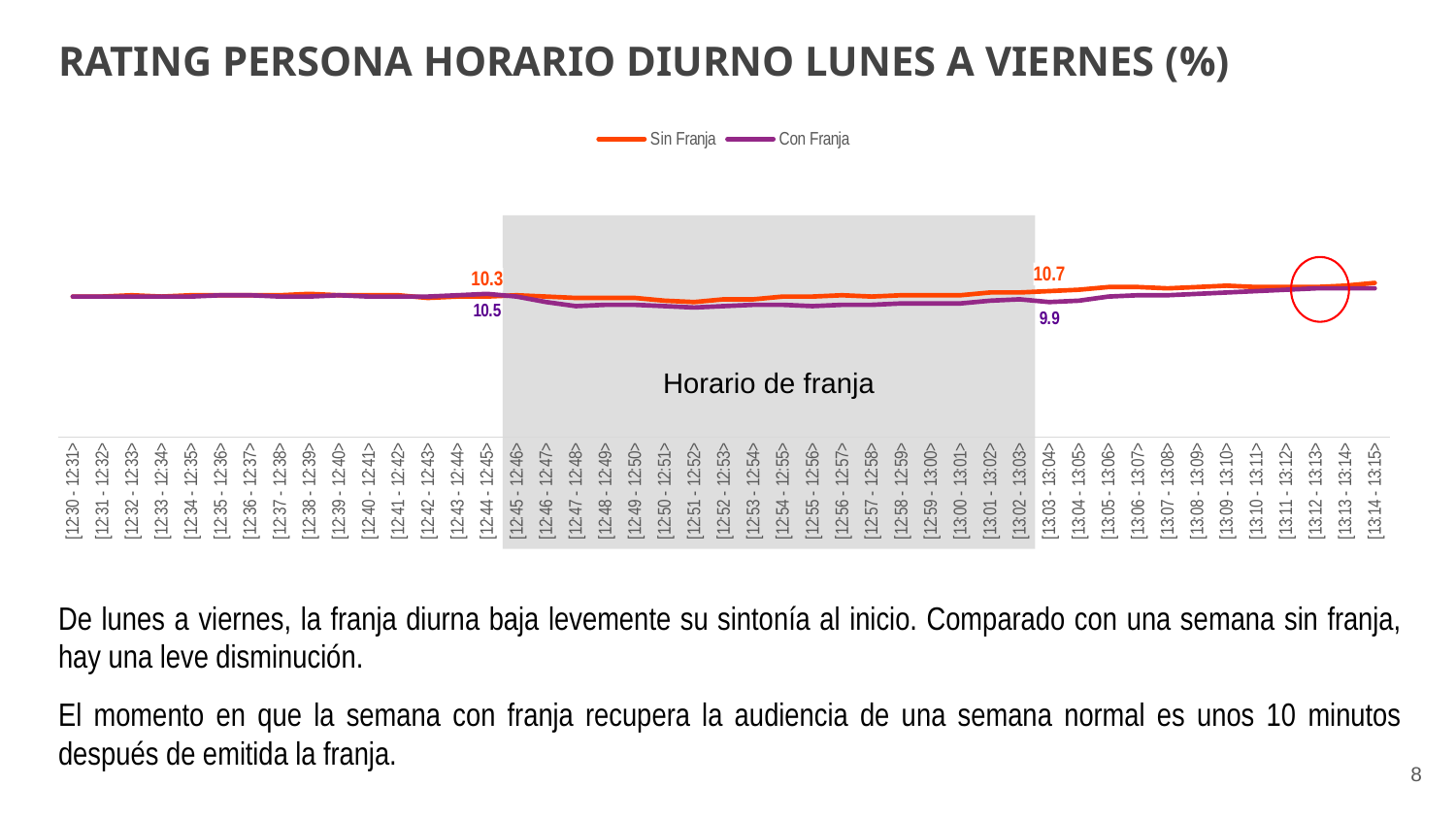
What kind of chart is shown on the slide? line chart What is the labelled value of the Sin Franja series at [13:03 - 13:04>? 10.7 What is the difference between the Sin Franja and Con Franja labelled values at [13:03 - 13:04>? 0.8 What label is written inside the shaded region of the chart? Horario de franja How many series does the legend list? 2 What is the difference between the Con Franja and Sin Franja labelled values at [12:44 - 12:45>? 0.2 What is the labelled value of the Sin Franja series at [12:44 - 12:45>? 10.3 At [13:03 - 13:04>, which series has the higher labelled value, Sin Franja or Con Franja? Sin Franja What is the labelled value of the Con Franja series at [13:03 - 13:04>? 9.9 What is the labelled value of the Con Franja series at [12:44 - 12:45>? 10.5 What are the two series named in the legend? Sin Franja and Con Franja How many time intervals are shown on the x axis? 45